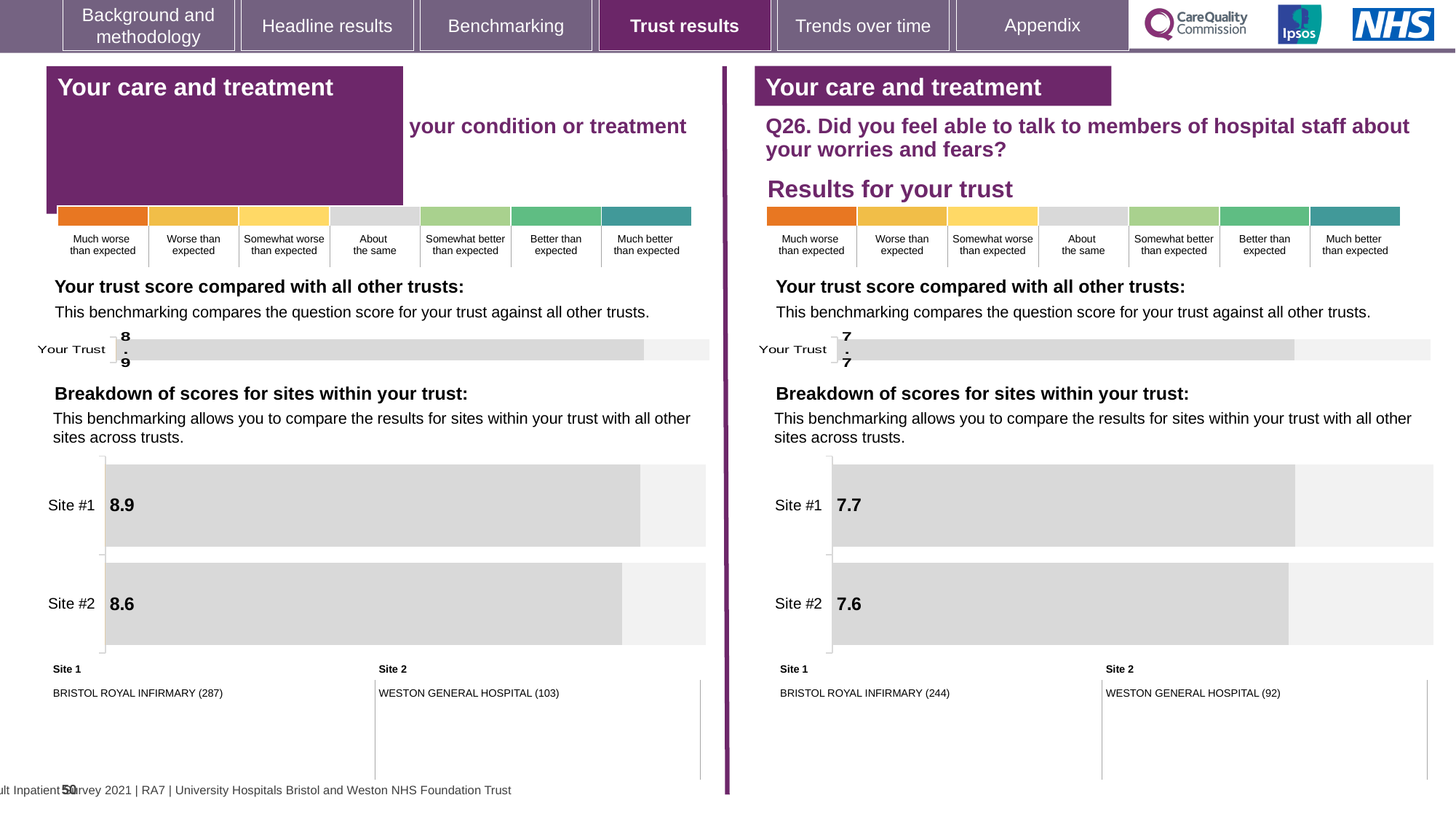
In the right panel (Q26) 'Your trust score compared with all other trusts' chart, what is the value for Your Trust? 7.7 In the left panel's 'Breakdown of scores for sites within your trust' chart, what is the difference between Site #1 and Site #2? 0.3 How many sites are shown in the left panel's 'Breakdown of scores for sites within your trust' chart? 2 In the right panel (Q26) 'Breakdown of scores for sites within your trust' chart, what is the value for Site #1? 7.7 In the right panel (Q26) 'Breakdown of scores for sites within your trust' chart, which site has the lower score? Site #2 In the left panel's 'Your trust score compared with all other trusts' chart, what is the value for Your Trust? 8.9 In the left panel's 'Breakdown of scores for sites within your trust' chart, which site has the higher score? Site #1 In the right panel (Q26) 'Breakdown of scores for sites within your trust' chart, what is the value for Site #2? 7.6 In the left panel's 'Breakdown of scores for sites within your trust' chart, what is the value for Site #2? 8.6 What type of chart is used for the 'Breakdown of scores for sites within your trust' in the right panel (Q26)? Bar chart In the left panel's 'Breakdown of scores for sites within your trust' chart, what is the value for Site #1? 8.9 In the right panel (Q26) 'Breakdown of scores for sites within your trust' chart, what is the difference between Site #1 and Site #2? 0.1